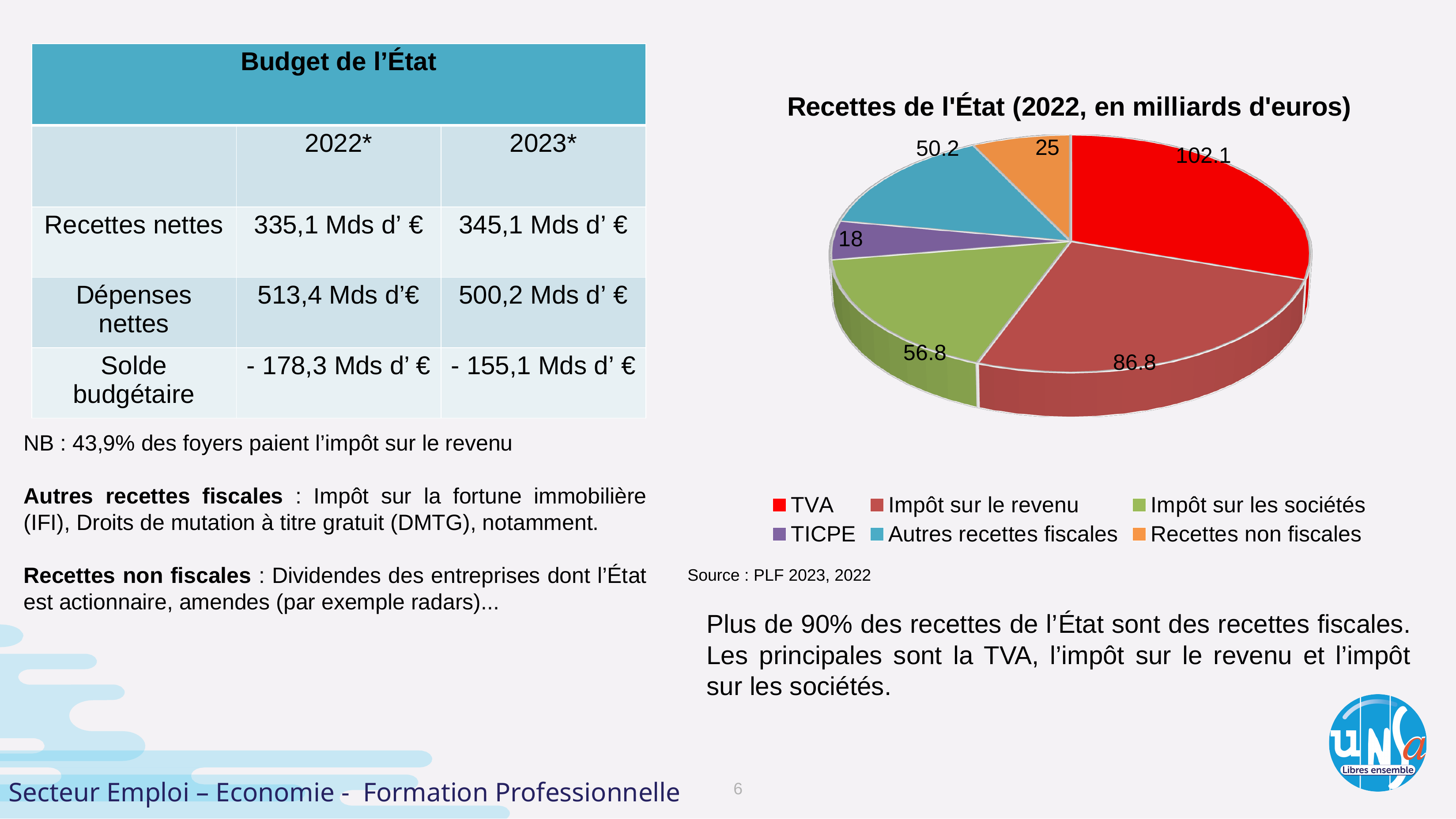
What is the difference between the Recettes non fiscales value and the TICPE value in the pie chart? 7 What is the value for Impôt sur le revenu in the pie chart? 86.8 What is the difference between the TVA value and the Impôt sur le revenu value in the pie chart? 15.3 Which category has the largest slice in the pie chart? TVA What is the value for Autres recettes fiscales in the pie chart? 50.2 How many slices does the pie chart have? 6 Which category has the smallest slice in the pie chart? TICPE What is the value for TICPE in the pie chart? 18 What is the value for TVA in the pie chart 'Recettes de l'État (2022, en milliards d'euros)'? 102.1 What colour is the Impôt sur les sociétés slice in the pie chart? green What kind of chart is 'Recettes de l'État (2022, en milliards d'euros)'? pie chart Which is larger in the pie chart: Impôt sur les sociétés or Autres recettes fiscales? Impôt sur les sociétés